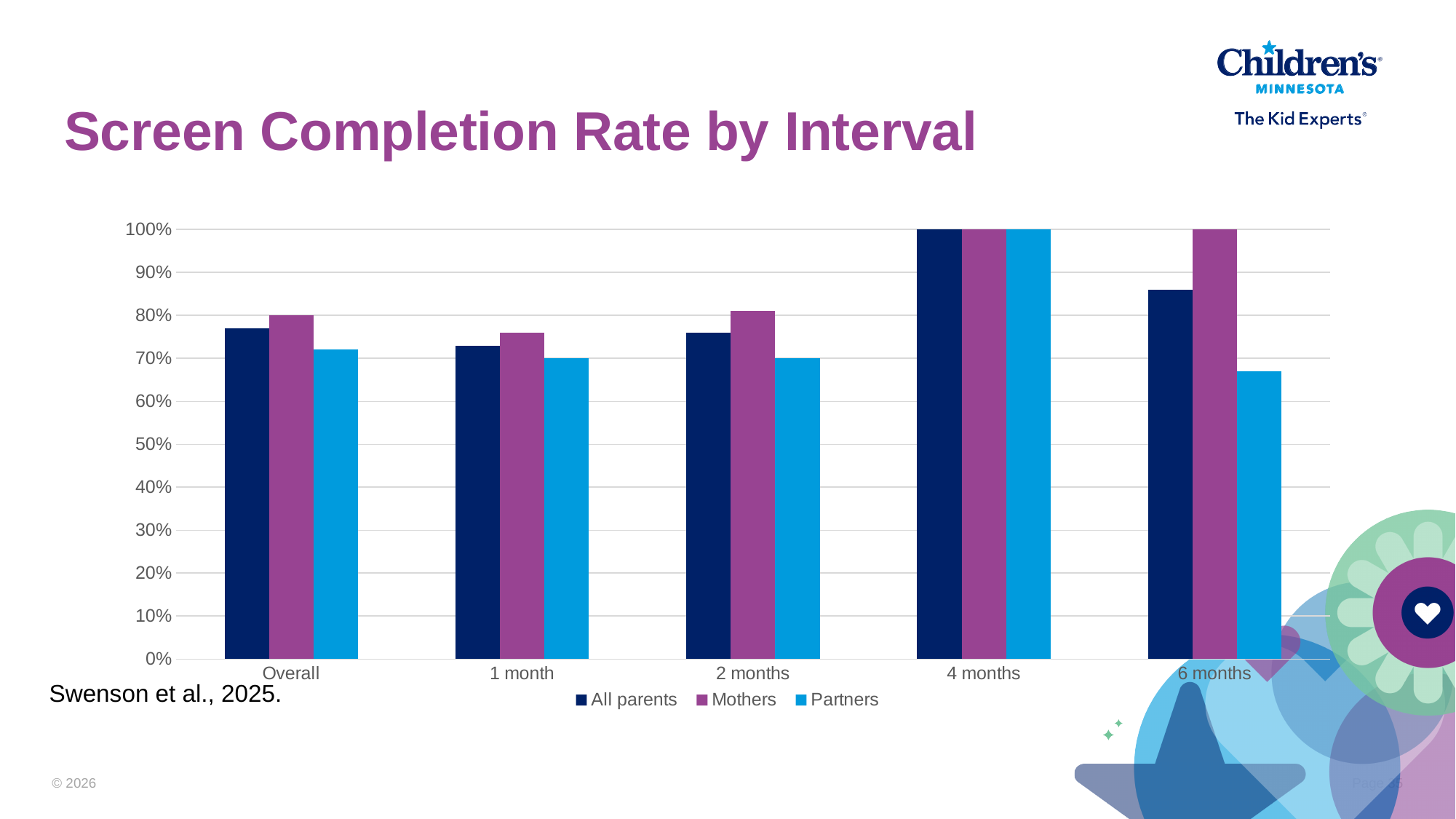
Which is larger at 2 months: the value for Mothers or the value for Partners? Mothers What is the screen completion rate for Partners at 1 month? 70% Is the value for All parents at 6 months greater or less than 80%? greater What type of chart is shown on the slide? bar chart What is the title of the chart? Screen Completion Rate by Interval Is the value for All parents at 1 month greater or less than 70%? greater At 6 months, which series has the lowest completion rate? Partners What is the screen completion rate for Mothers at 6 months? 100% How many interval categories are shown on the x axis? 5 How many series does the legend list? 3 Is the value for Partners at 6 months greater or less than 70%? less What is the screen completion rate for Mothers at 4 months? 100%